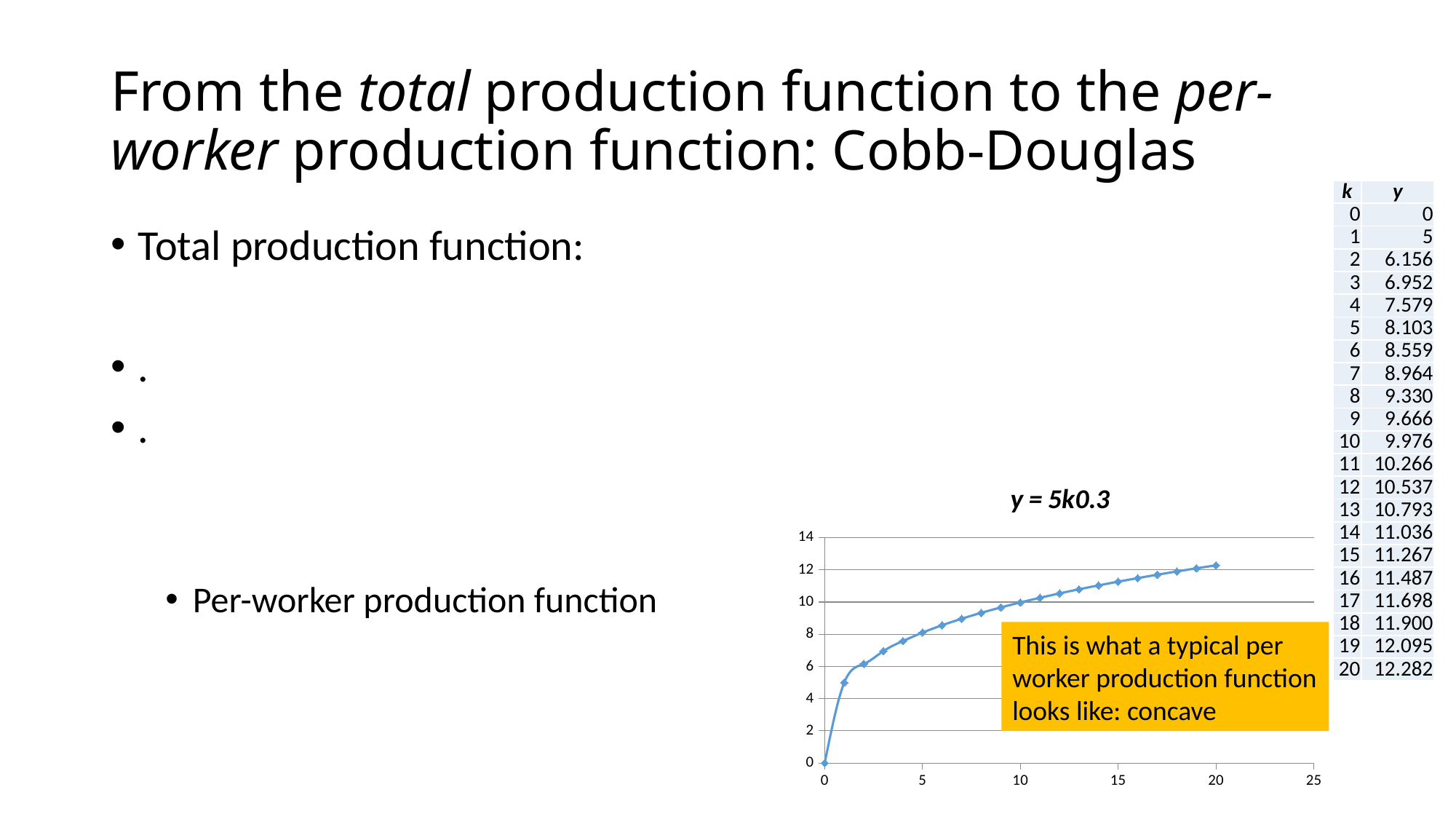
At which value of k is y highest? 20 According to the table on the slide, what is the value of y when k = 20? 12.282 How many data points are plotted on the chart (k = 0 through 20)? 21 What kind of chart is shown on the slide? line chart Is the plotted value of y at k = 5 greater or less than 6? greater Do the plotted values rise or fall as k increases along the x axis? rise At which value of k is y lowest? 0 What is the title of the chart? y = 5k0.3 According to the table on the slide, what is the value of y when k = 10? 9.976 Using the table values, what is the difference between y at k = 20 and y at k = 10? 2.306 Is the plotted value of y at k = 20 greater or less than 14? less Which is larger: y at k = 10 or y at k = 5? y at k = 10